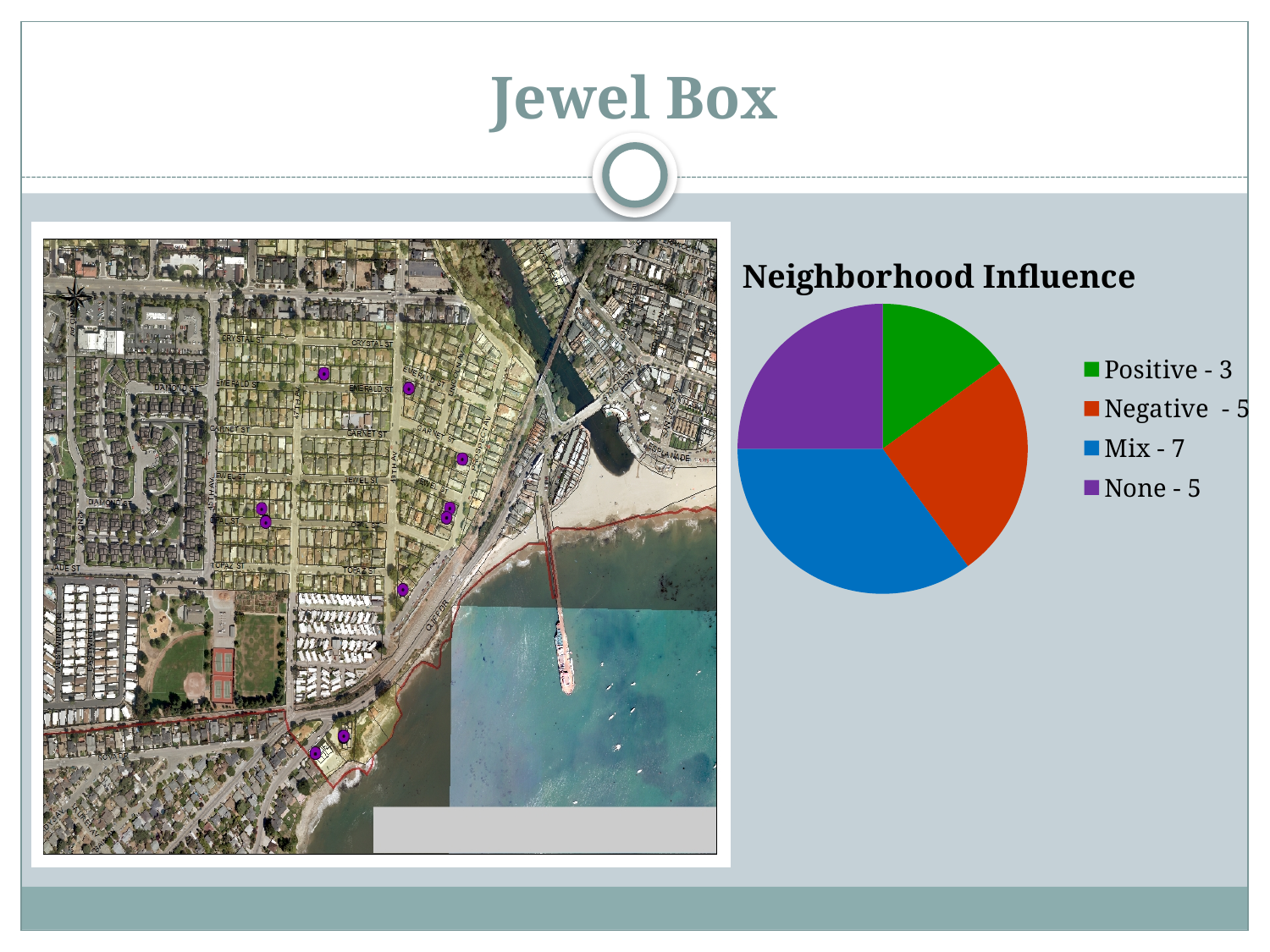
What is the value for Mix in the Neighborhood Influence chart? 7 What kind of chart is shown on the slide? pie chart How many categories does the pie chart have? 4 Which is larger, the value for Negative or the value for Positive? Negative What colour is the Mix slice in the pie chart? blue What is the title of the chart? Neighborhood Influence Which category has the largest slice of the pie? Mix What is the value for Negative in the Neighborhood Influence chart? 5 What is the value for Positive in the Neighborhood Influence chart? 3 What share of the pie does the Mix slice represent? 35% Which category has the smallest slice of the pie? Positive What is the difference between the values for Mix and Positive? 4